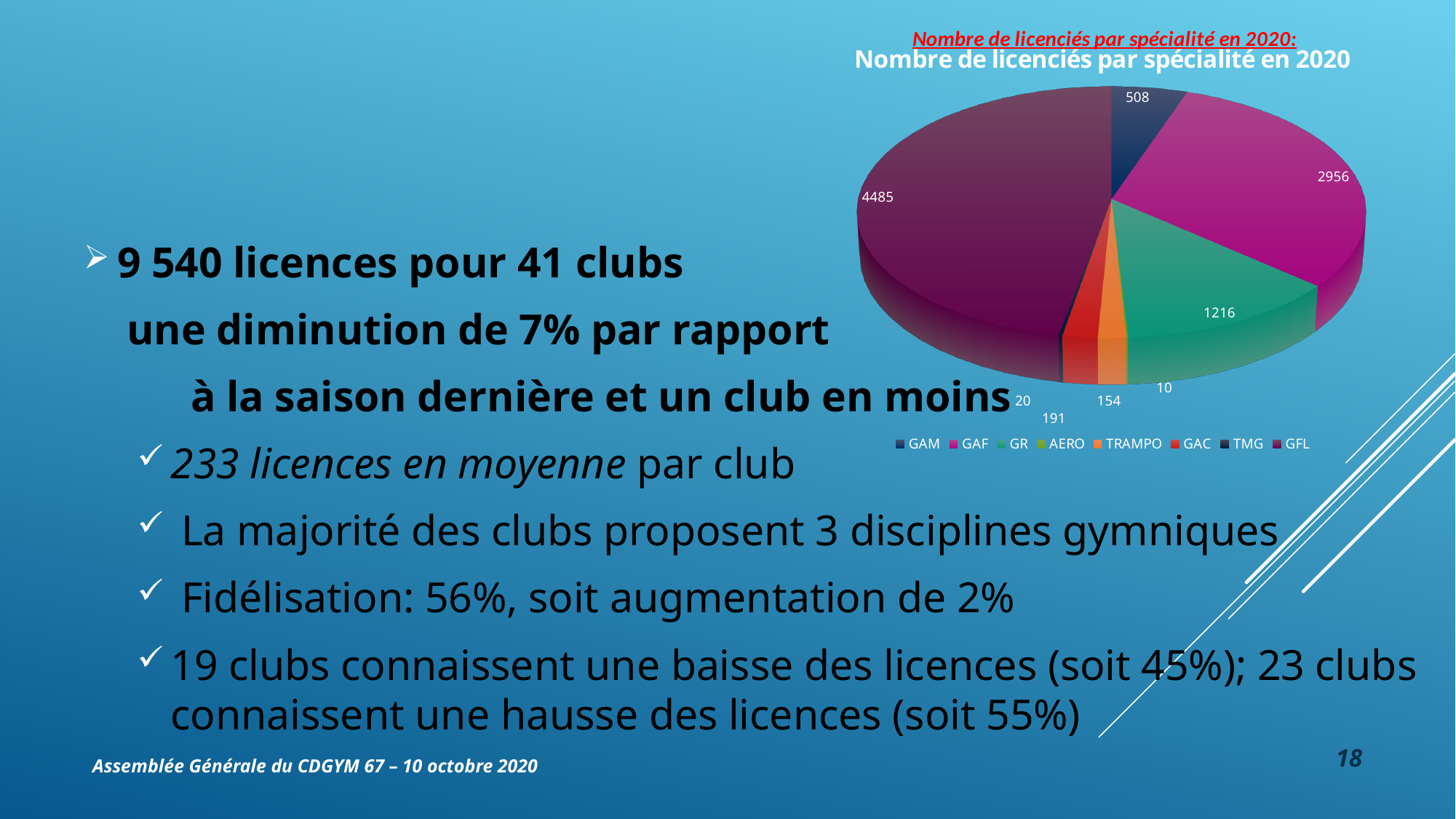
What is the value for GFL in the chart? 4485 Which category has the smallest slice in the chart? AERO What is the value for TRAMPO in the chart? 154 Which category has the largest slice in the chart? GFL What is the title of the chart? Nombre de licenciés par spécialité en 2020 What type of chart is shown on the slide? Pie chart What is the difference between the values for GAF and GR? 1740 What is the value for GR in the chart? 1216 What is the value for GAM in the chart? 508 How many categories does the chart's legend list? 8 What is the value for GAF in the chart? 2956 Which is larger, the value for GAC or the value for TRAMPO? GAC